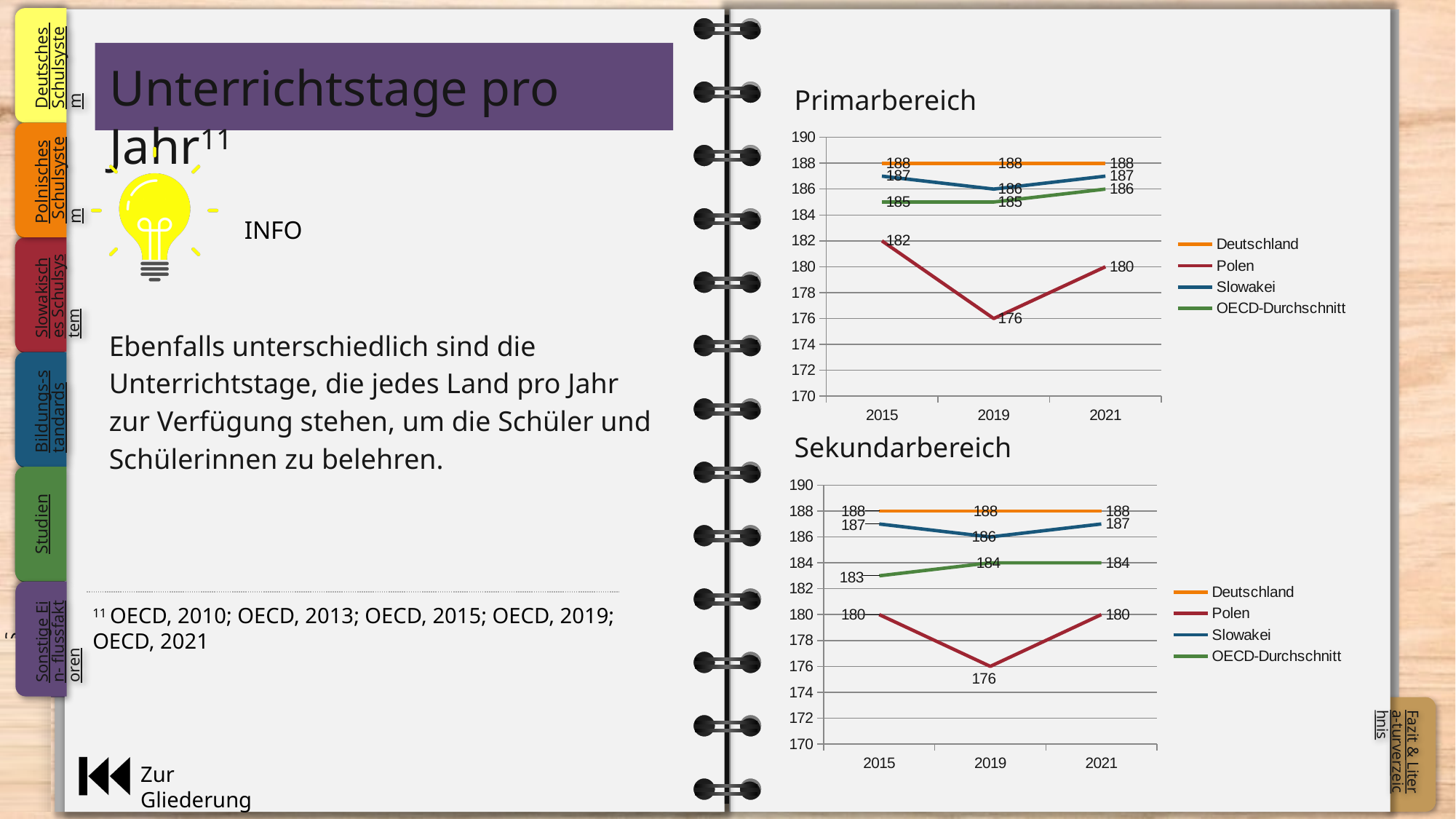
In the Sekundarbereich chart, what is the difference between Slowakei and Polen in 2019? 10 In the Primarbereich chart, what is the difference between Deutschland and Polen in 2015? 6 In the Primarbereich chart, which is larger in 2021: Slowakei or OECD-Durchschnitt? Slowakei In the Primarbereich chart, what is the value for Polen in 2019? 176 In the Sekundarbereich chart, which series has the highest value in 2021? Deutschland In the Sekundarbereich chart, what is the value for OECD-Durchschnitt in 2015? 183 In the Sekundarbereich chart, what is the value for Slowakei in 2019? 186 In the Primarbereich chart, which series has the lowest value in 2019? Polen What kind of chart is the Sekundarbereich chart? Line chart How many series does the legend of the Sekundarbereich chart list? 4 How many years are shown on the x axis of the Primarbereich chart? 3 In the Primarbereich chart, what is the value for OECD-Durchschnitt in 2021? 186